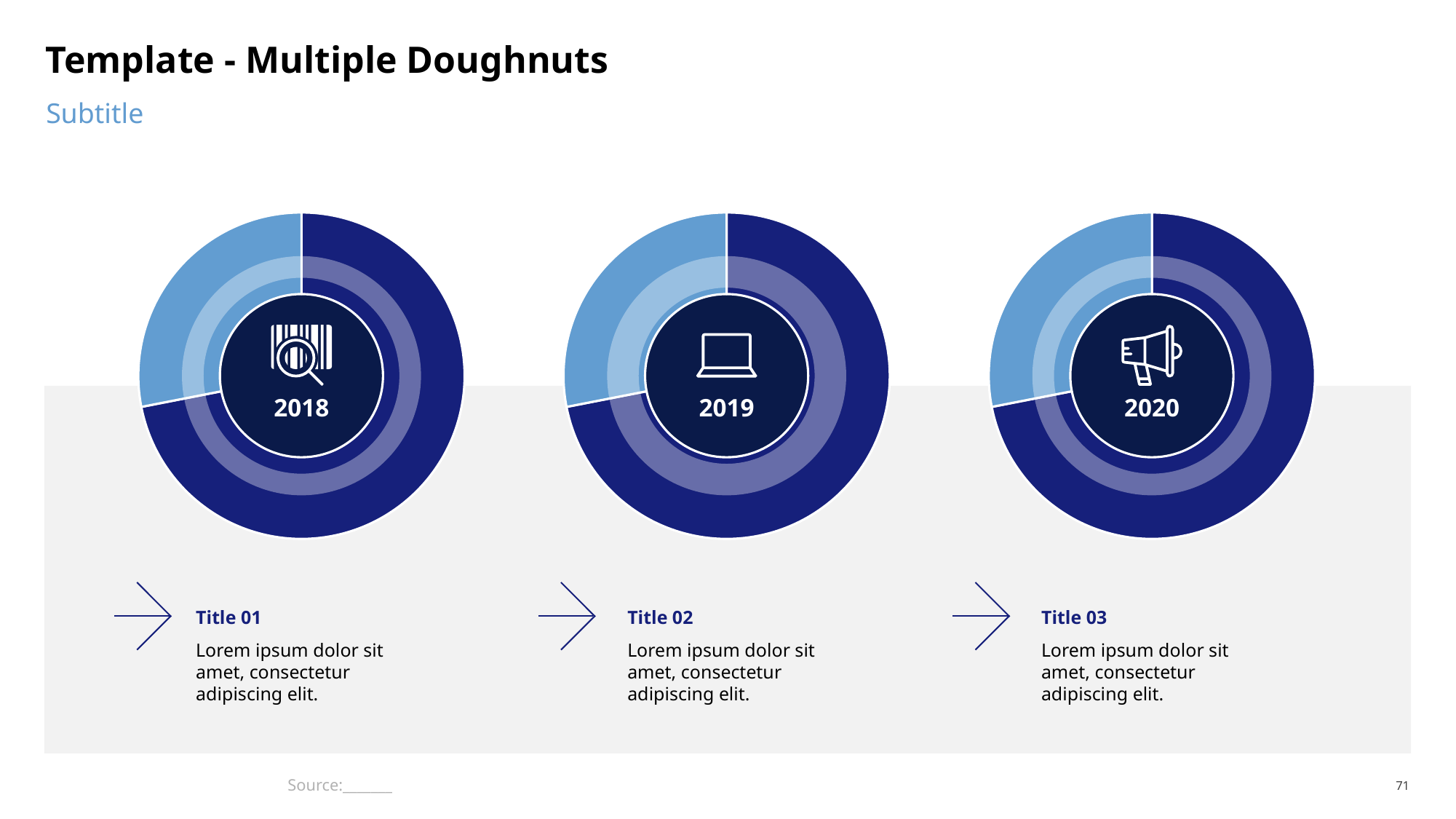
What kind of chart is shown for 2018? doughnut chart What is the title of the slide containing the doughnut charts? Template - Multiple Doughnuts In the 2018 doughnut chart, which slice of the outer ring is larger, the dark blue or the light blue? dark blue In the 2019 doughnut chart, which slice of the outer ring is larger, the dark blue or the light blue? dark blue How many slices does the outer ring of the 2020 doughnut chart have? 2 How many slices does the outer ring of the 2019 doughnut chart have? 2 In the 2020 doughnut chart, which slice of the outer ring is smaller, the dark blue or the light blue? light blue How many doughnut charts are on the slide? 3 What year label is in the centre of the middle doughnut chart? 2019